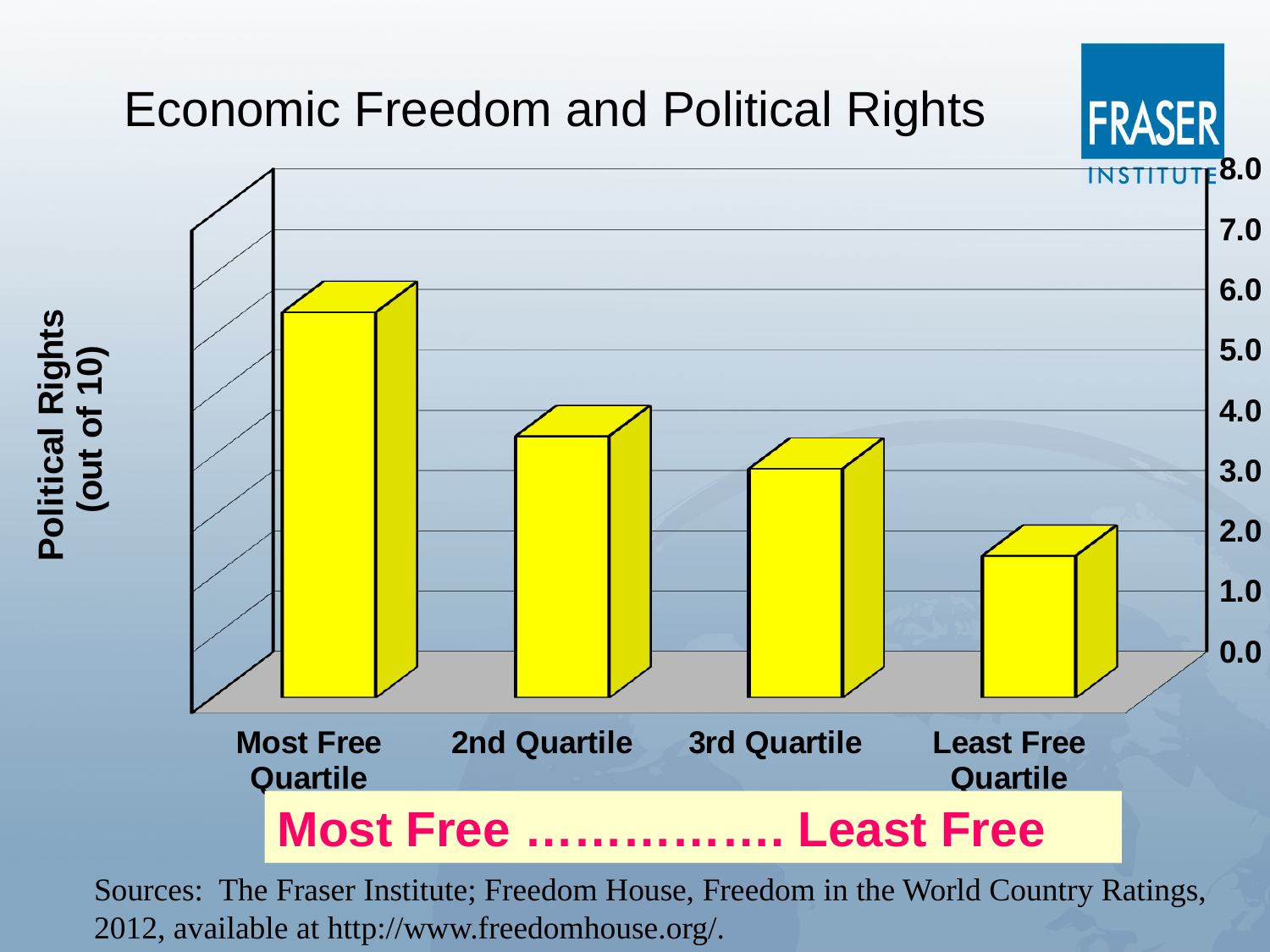
What kind of chart is shown on the slide? bar chart Is the value for the Most Free Quartile greater or less than 5.0? greater Which quartile has the lowest political rights value? Least Free Quartile Which has a larger political rights value, the 2nd Quartile or the 3rd Quartile? 2nd Quartile Is the value for the 3rd Quartile greater or less than 2.0? greater What is the label on the vertical axis of the chart? Political Rights (out of 10) Which quartile has the highest political rights value? Most Free Quartile How many quartile categories are plotted on the chart? 4 What is the title of the chart? Economic Freedom and Political Rights Do the political rights values rise or fall moving from the Most Free Quartile to the Least Free Quartile? fall